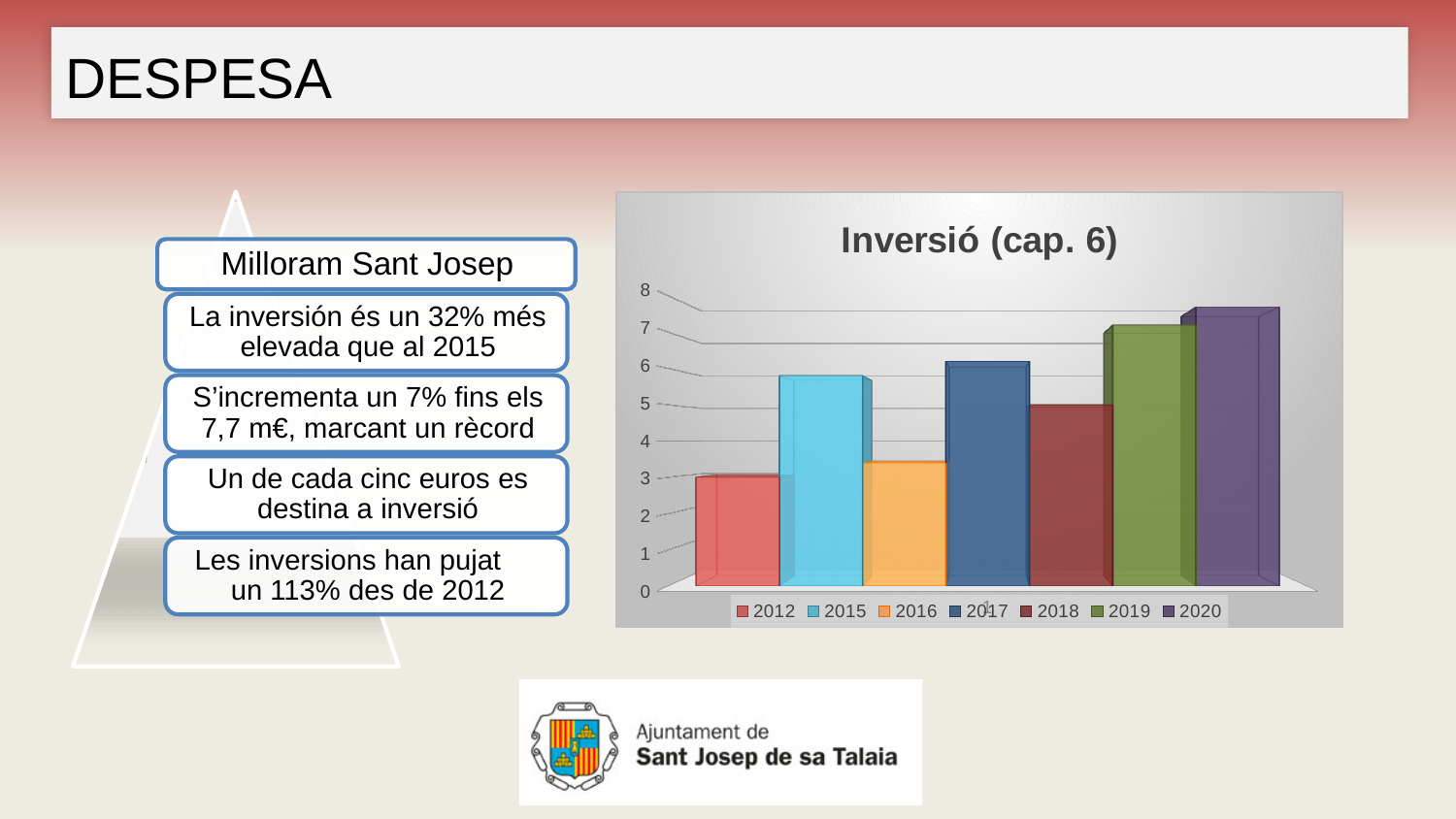
Which is larger, the value for 2017 or the value for 2018? 2017 Is the value for 2019 greater or less than 6? greater Which year has the lowest bar in the chart? 2012 What type of chart is shown on the slide? bar chart What is the title of the chart? Inversió (cap. 6) Is the value for 2020 greater or less than 7? greater Is the value for 2012 greater or less than 4? less How many bars are plotted in the chart? 7 Which year has the highest bar in the chart? 2020 How many entries does the chart legend list? 7 Which is larger, the value for 2015 or the value for 2016? 2015